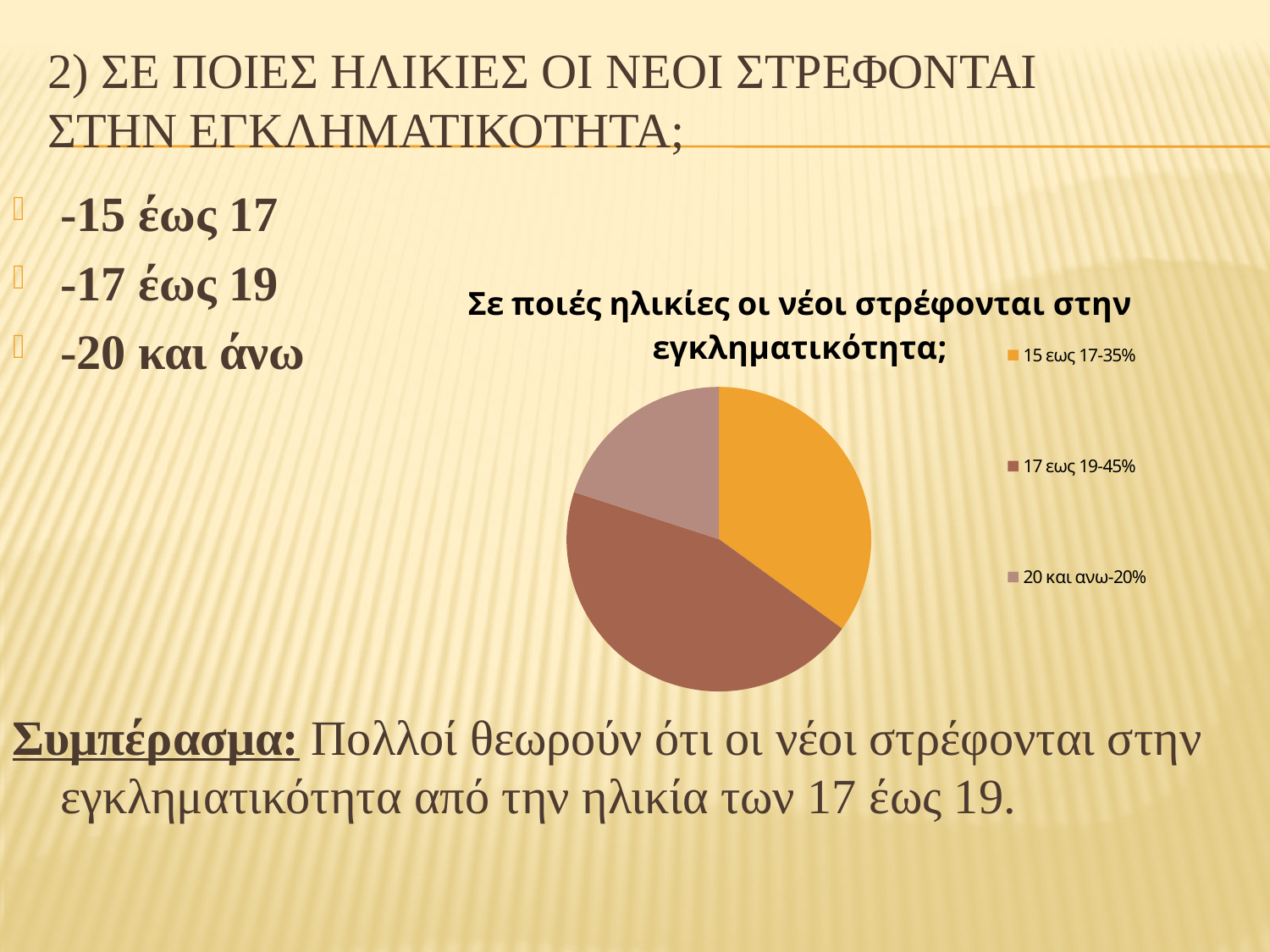
What is the combined share of the 15 εως 17 and 20 και ανω groups? 55% What percentage does the legend give for the 15 εως 17 age group? 35% What kind of chart is shown on the slide? pie chart Which is larger, the share for 15 εως 17 or the share for 20 και ανω? 15 εως 17 Which age group has the largest share of the pie? 17 εως 19 What is the difference in percentage points between the 17 εως 19 and 15 εως 17 groups? 10 How many slices does the pie chart have? 3 What percentage does the legend give for the 20 και ανω age group? 20% What colour is the slice for the 17 εως 19 age group? brown What percentage does the legend give for the 17 εως 19 age group? 45% What is the title of the pie chart? Σε ποιές ηλικίες οι νέοι στρέφονται στην εγκληματικότητα; Which age group has the smallest share of the pie? 20 και ανω